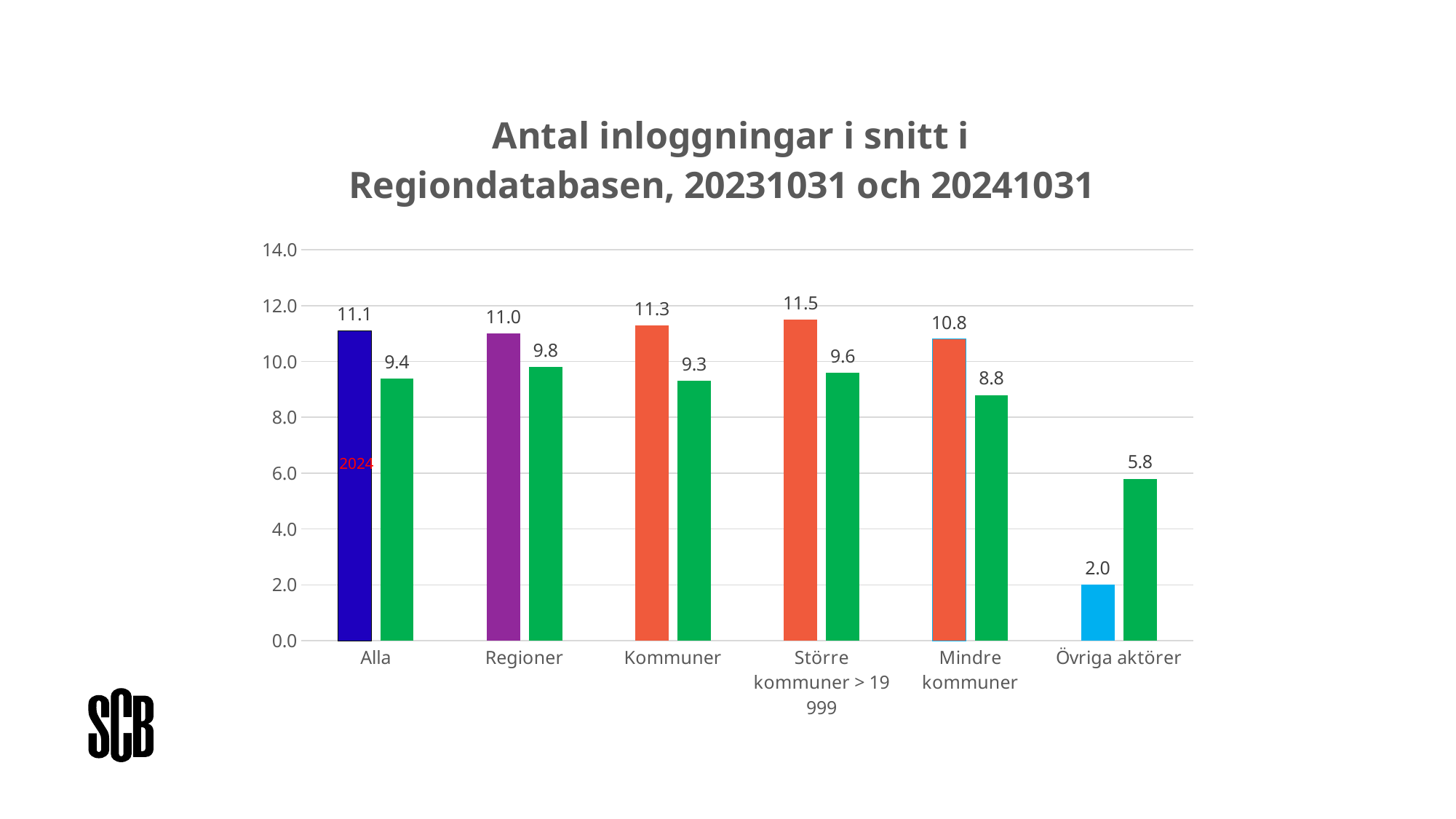
What is the difference between the two bars for Alla (11.1 and 9.4)? 1.7 What type of chart is shown on the slide? bar chart How many categories are shown on the x axis? 6 What is the value of the green bar for Övriga aktörer? 5.8 Among the green bars, which category has the highest value? Regioner What is the value of the left (first) bar for Större kommuner > 19 999? 11.5 What is the value of the green bar for Mindre kommuner? 8.8 Which category has the highest bar overall in the chart? Större kommuner > 19 999 Which category has the lowest bar overall in the chart? Övriga aktörer Which is larger: the left bar for Kommuner or the left bar for Regioner? Kommuner What is the difference between the green bar and the blue bar for Övriga aktörer? 3.8 For Övriga aktörer, which bar is larger, the blue bar or the green bar? the green bar